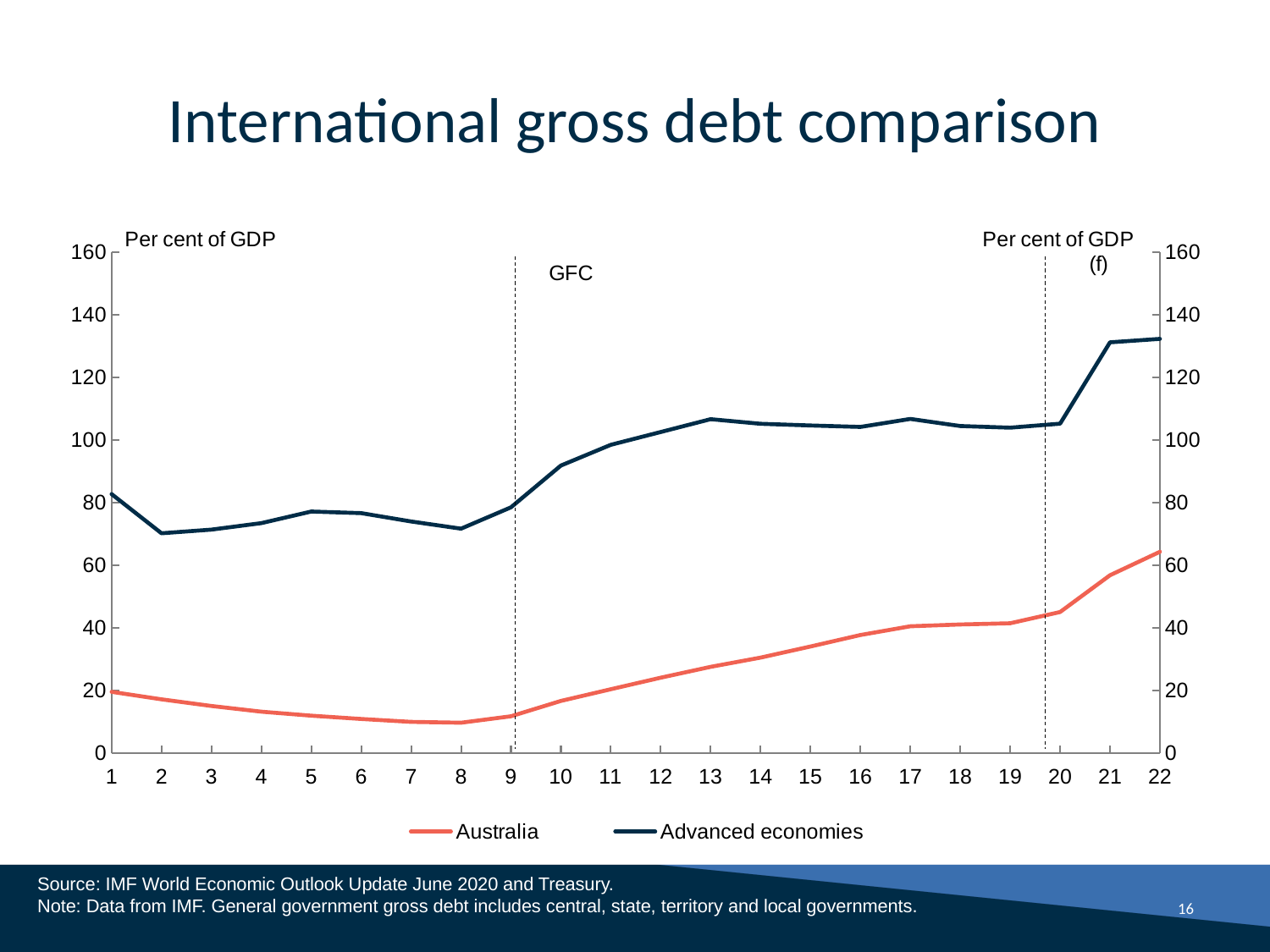
At which x-axis point does the Australia series reach its highest value? 22 Is the value for Advanced economies at point 13 greater or less than 100? greater How many points are labelled along the x axis? 22 Does the Australia series rise or fall from point 9 to point 22? rise What kind of chart is shown on the slide? line chart How many series does the legend list? 2 Is the value for Australia at point 8 greater or less than 20? less At point 22, which series has the higher value, Australia or Advanced economies? Advanced economies Is the value for Advanced economies at point 21 greater or less than 120? greater What label is shown next to the first vertical dashed line on the chart? GFC